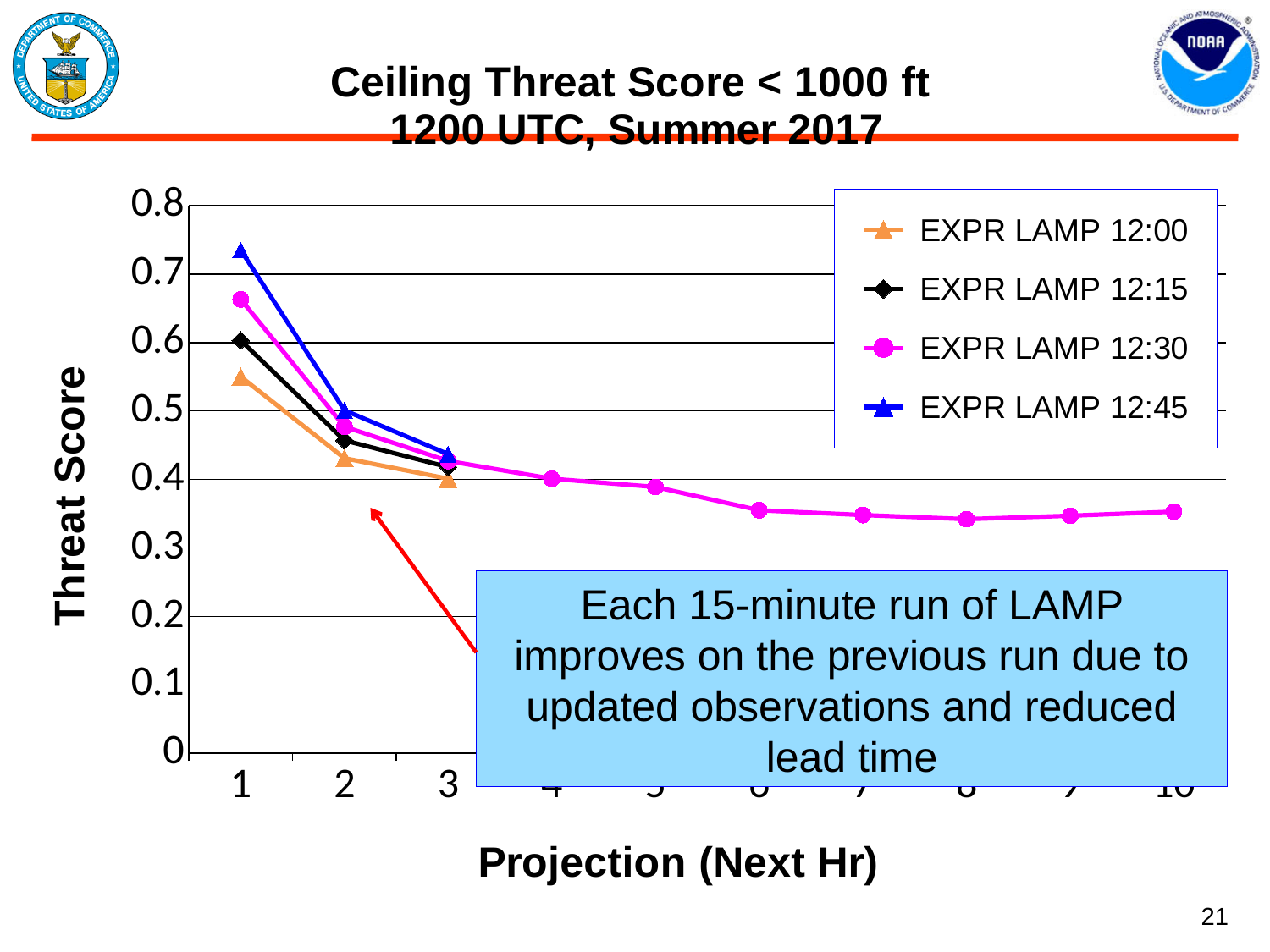
Which series has the lowest threat score at projection 1? EXPR LAMP 12:00 Is the value for EXPR LAMP 12:45 at projection 1 greater or less than 0.7? greater Which series has the highest threat score at projection 1? EXPR LAMP 12:45 What kind of chart is shown on the slide? line chart Is the value for EXPR LAMP 12:30 at projection 1 greater or less than 0.6? greater At projection 2, which is larger: EXPR LAMP 12:45 or EXPR LAMP 12:00? EXPR LAMP 12:45 How many series does the legend list? 4 Does the EXPR LAMP 12:30 threat score generally rise or fall as the projection increases from 1 to 8? fall Is the value for EXPR LAMP 12:00 at projection 1 greater or less than 0.6? less What is the label of the y axis? Threat Score What is the title of the chart? Ceiling Threat Score < 1000 ft 1200 UTC, Summer 2017